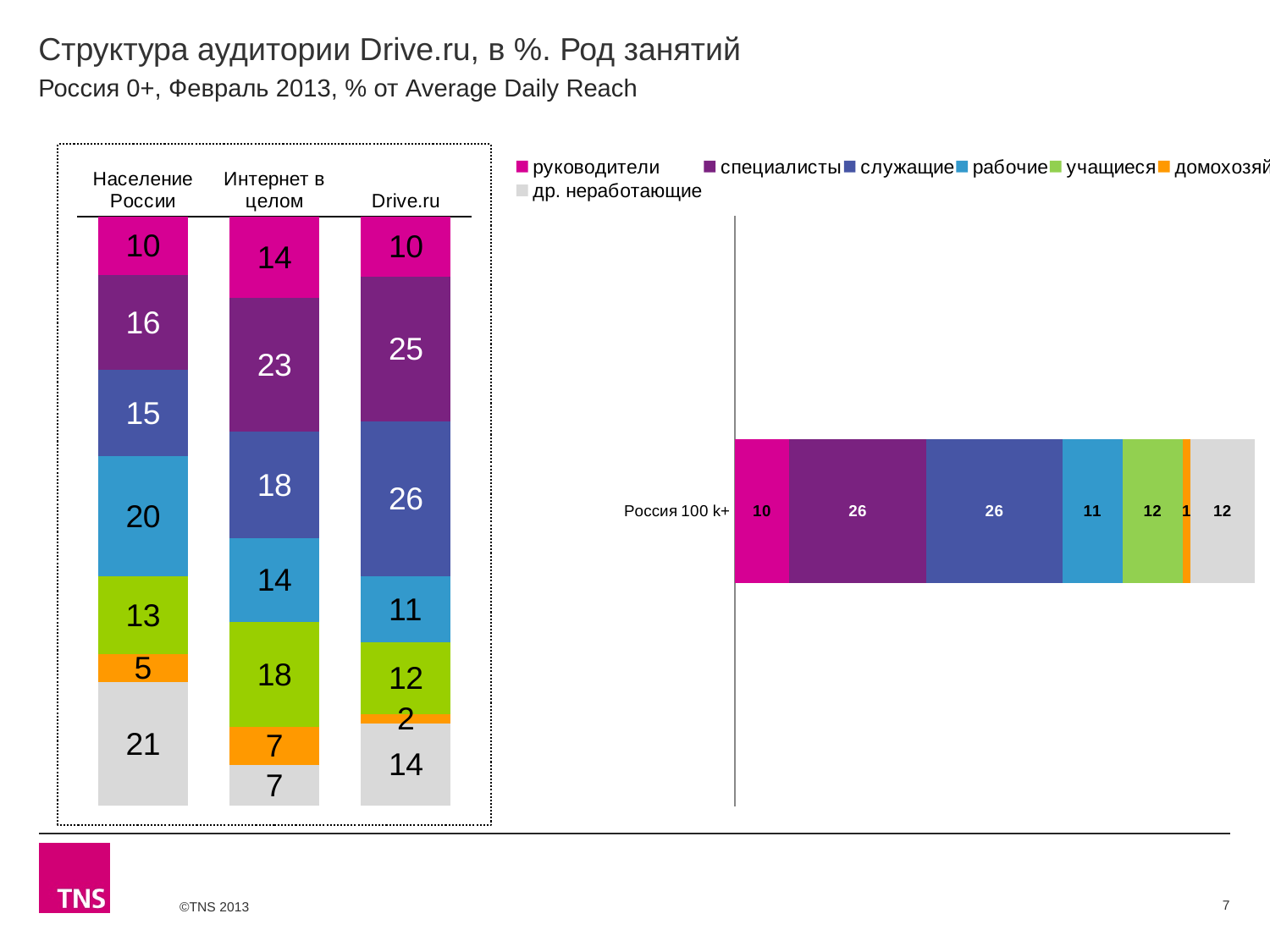
In the right horizontal bar chart for Россия 100 k+, what is the value of the домохозяйки segment? 1 In the left stacked bar chart, what is the value of the purple (специалисты) segment for Drive.ru? 25 In the left stacked bar chart, which segment of the Drive.ru bar is the largest? служащие (26) In the right horizontal bar chart for Россия 100 k+, what is the value of the рабочие segment? 11 How many series does the legend on the right list? 7 In the left stacked bar chart, what is the value of the bottom grey (др. неработающие) segment for Население России? 21 In the left stacked bar chart, what is the value of the top (pink, руководители) segment for Интернет в целом? 14 How many bars (categories) does the left stacked bar chart show? 3 In the left stacked bar chart, what is the difference between the специалисты segment for Drive.ru and for Население России? 9 In the left stacked bar chart, is the учащиеся segment larger for Интернет в целом or for Drive.ru? Интернет в целом What type of chart is shown on the right side of the slide? Stacked horizontal bar chart In the left stacked bar chart, which segment of the Drive.ru bar is the smallest? домохозяйки (2)